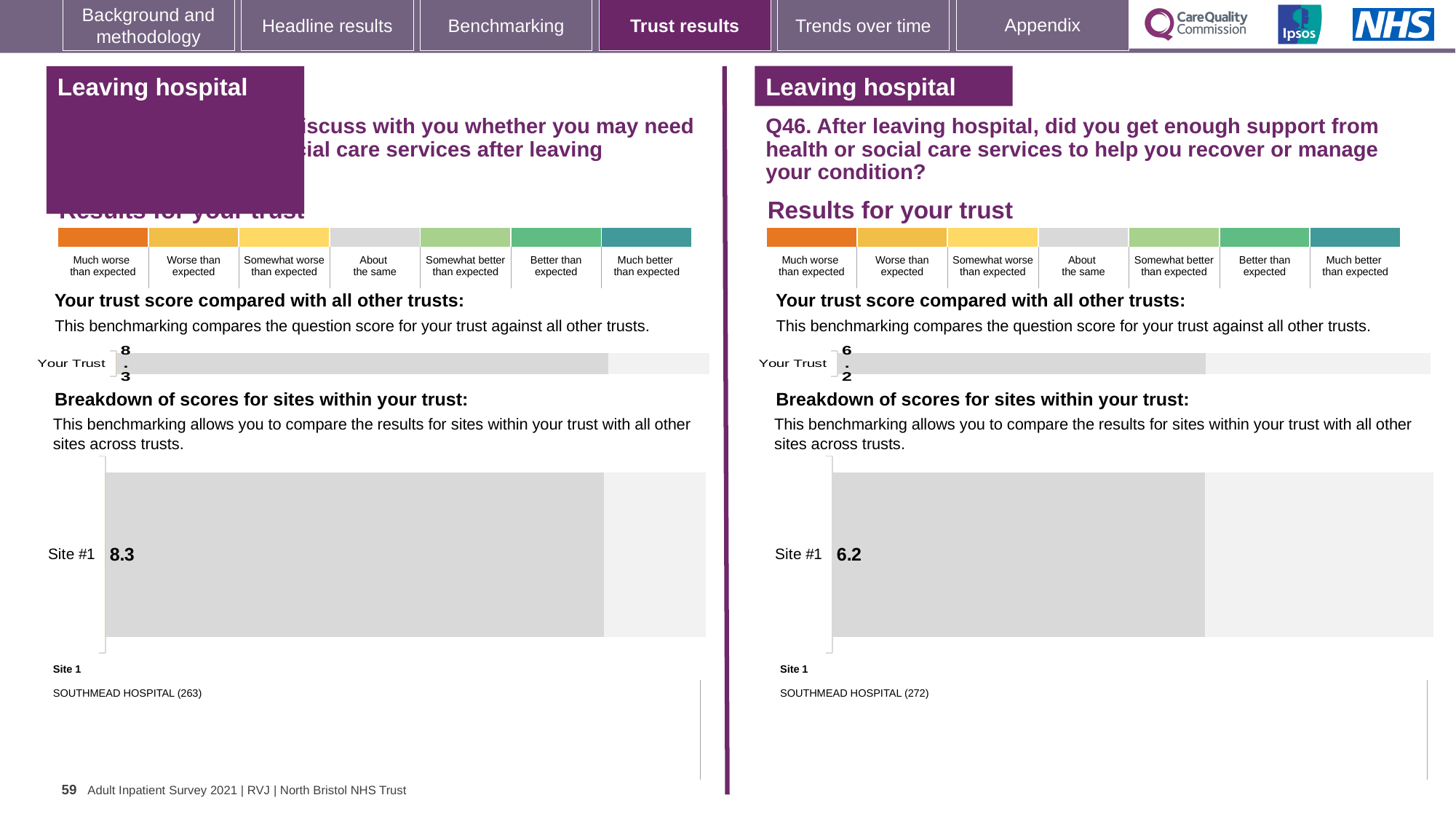
Which hospital is listed as Site 1 on the right half of the slide (Q46)? SOUTHMEAD HOSPITAL (272) Which is larger: the Your Trust score on the left half of the slide or the Your Trust score on the right half (Q46)? Left half (8.3) On the right half of the slide (Q46), what is the score shown for Your Trust? 6.2 In the right 'Breakdown of scores for sites within your trust' chart (Q46), what is the score for Site #1? 6.2 What is the difference between the Site #1 score on the left half of the slide and the Site #1 score on the right half (Q46)? 2.1 On the left half of the slide, what is the score shown for Your Trust? 8.3 In the left 'Breakdown of scores for sites within your trust' chart, what is the score for Site #1? 8.3 How many sites are shown in the left 'Breakdown of scores for sites within your trust' chart? 1 How many sites are shown in the right 'Breakdown of scores for sites within your trust' chart (Q46)? 1 What type of chart is used to show the Your Trust score on the right half of the slide (Q46)? Bar chart Which hospital is listed as Site 1 on the left half of the slide? SOUTHMEAD HOSPITAL (263)